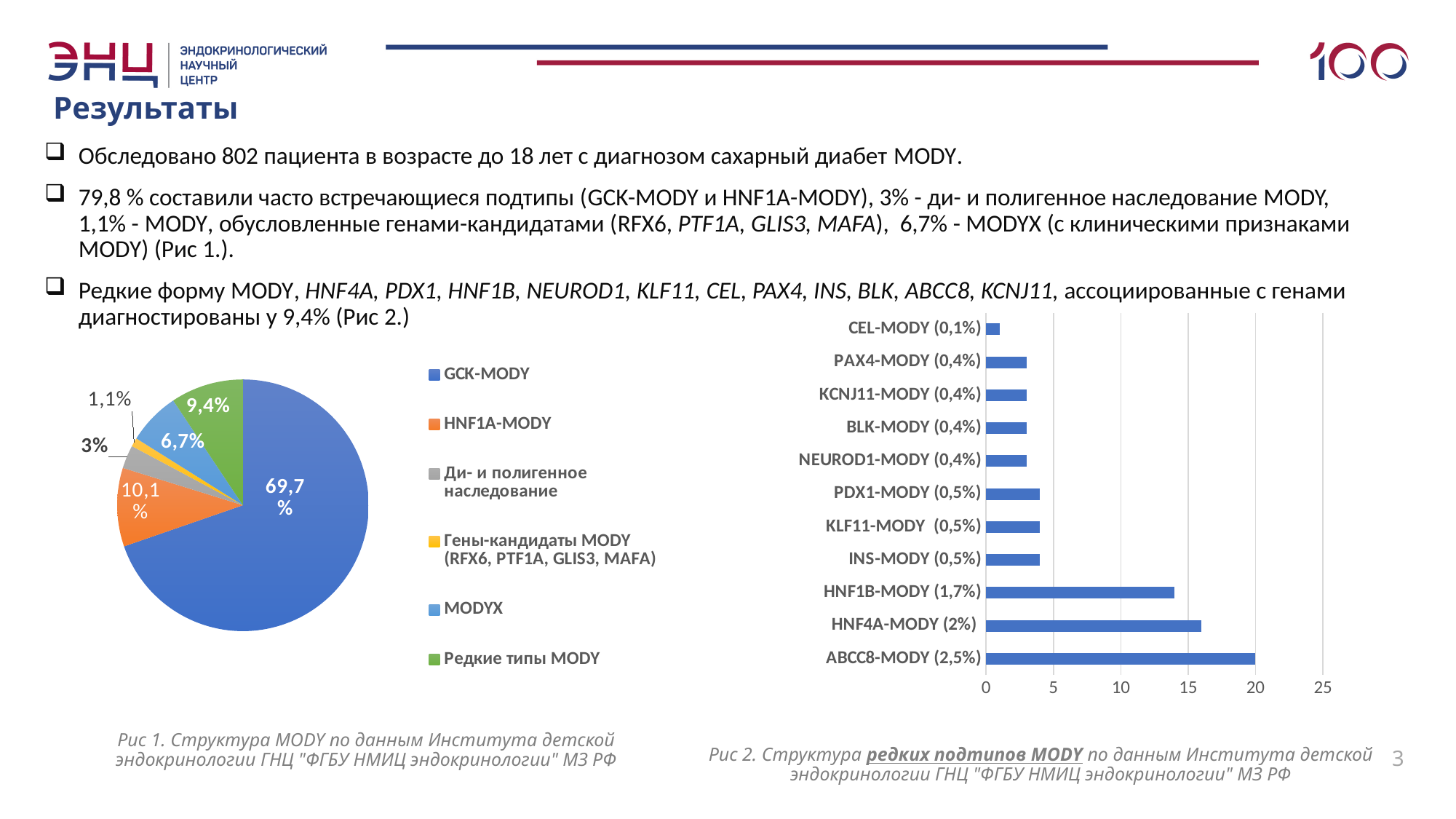
In the pie chart (Рис 1), how many slices are there? 6 In the bar chart (Рис 2), which category has the shortest bar? CEL-MODY (0,1%) In the pie chart (Рис 1), which category has the smallest slice? Гены-кандидаты MODY (RFX6, PTF1A, GLIS3, MAFA) In the pie chart (Рис 1), what share does GCK-MODY have? 69,7% In the pie chart (Рис 1), which category has the largest slice? GCK-MODY In the pie chart (Рис 1), what share does HNF1A-MODY have? 10,1% In the bar chart (Рис 2), what value does the bar for ABCC8-MODY reach on the axis? 20 In the bar chart (Рис 2), which category has the longest bar? ABCC8-MODY (2,5%) In the pie chart (Рис 1), which is larger: MODYX or Редкие типы MODY? Редкие типы MODY In the bar chart (Рис 2), how many categories are shown? 11 In the bar chart (Рис 2), is the value for HNF1B-MODY greater or less than 10? greater What type of chart is Рис 2? Bar chart